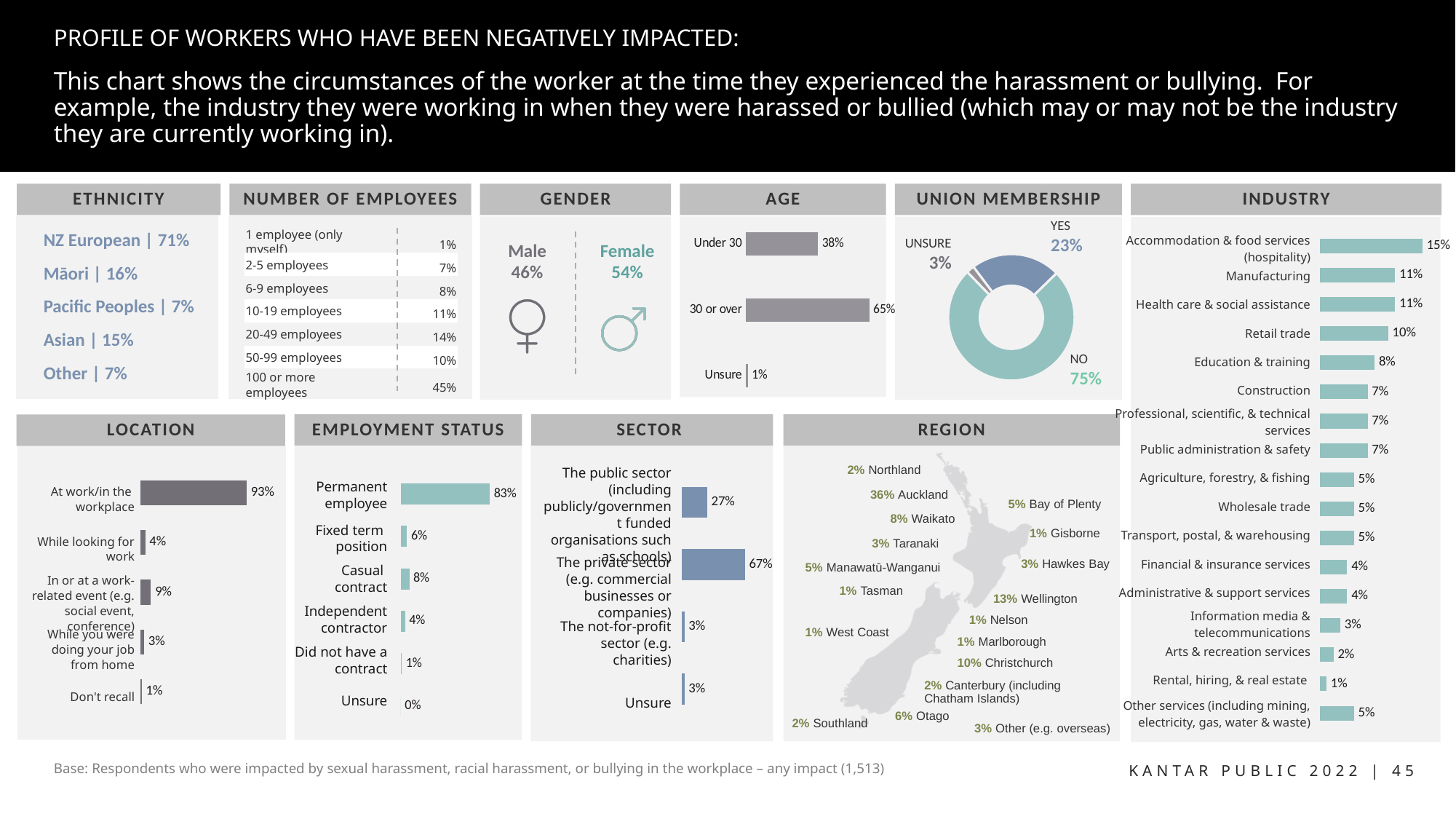
In the SECTOR chart, what is the value for the private sector? 67% In the NUMBER OF EMPLOYEES chart, what is the value for 100 or more employees? 45% In the REGION chart, what is the value for Auckland? 36% In the AGE chart, what is the difference between the values for 30 or over and Under 30? 27% In the EMPLOYMENT STATUS chart, which is larger: Casual contract or Fixed term position? Casual contract In the AGE chart, what is the value for 30 or over? 65% In the NUMBER OF EMPLOYEES chart, which category has the lowest value? 1 employee (only myself) In the INDUSTRY chart, which industry has the highest value? Accommodation & food services (hospitality) In the INDUSTRY chart, what is the value for Retail trade? 10% What kind of chart is the UNION MEMBERSHIP chart? Donut chart In the LOCATION chart, what is the value for At work/in the workplace? 93% In the UNION MEMBERSHIP chart, what share of the donut is NO? 75%